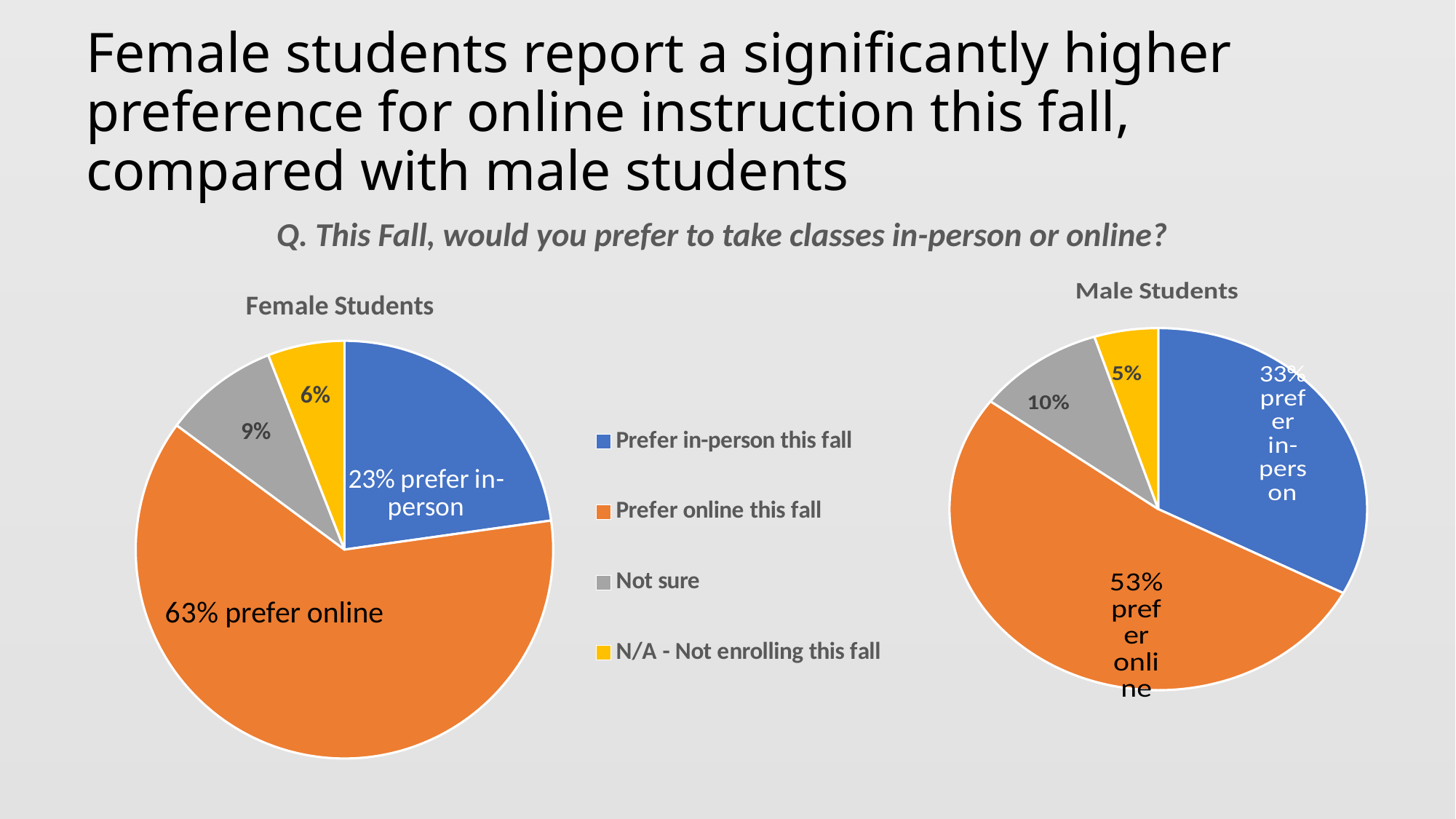
What is the difference between the share of female students and male students who prefer online this fall? 10 percentage points Which is larger: the share of male students who prefer in-person this fall or the share of female students who prefer in-person this fall? Male students In the Male Students chart, what share of students are N/A - Not enrolling this fall? 5% In the Female Students chart, what share of students prefer in-person this fall? 23% In the Female Students chart, what share of students are not sure? 9% In the Male Students chart, what share of students prefer online this fall? 53% In the Male Students chart, which category has the smallest slice? N/A - Not enrolling this fall In the Female Students chart, what share of students prefer online this fall? 63% What type of chart is used for the Male Students data? Pie chart In the Female Students chart, which category has the largest slice? Prefer online this fall In the Male Students chart, what share of students prefer in-person this fall? 33% How many slices does the Female Students pie chart have? 4